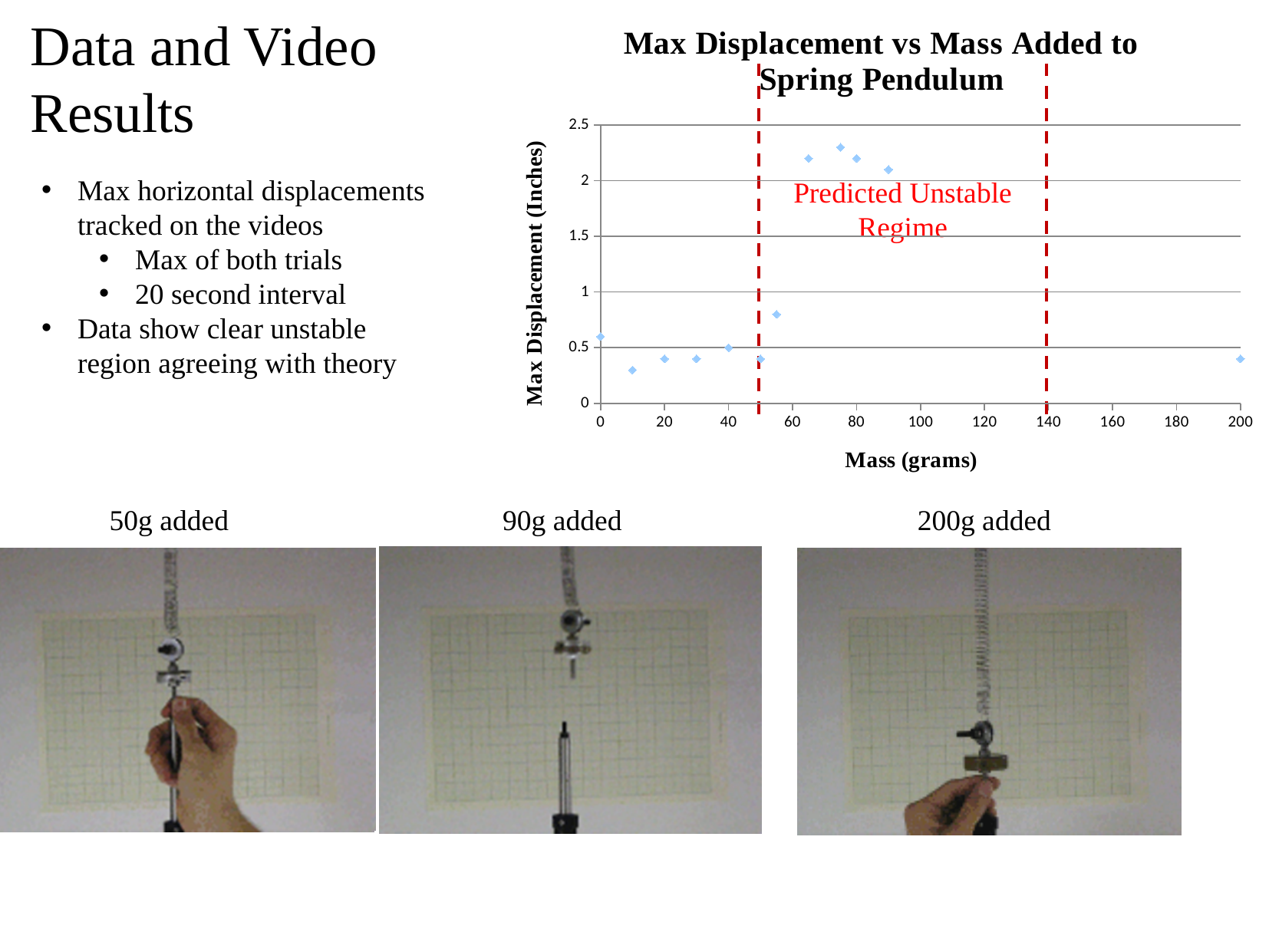
Is the max displacement at 75 grams greater or less than 2 inches? greater Is the max displacement at 200 grams greater or less than 1 inch? less What kind of chart is shown on the slide? scatter plot How many data points are plotted on the chart? 12 Which has the larger max displacement: 65 grams or 50 grams? 65 grams What is the title of the chart? Max Displacement vs Mass Added to Spring Pendulum Is the max displacement at 90 grams greater or less than 1.5 inches? greater Which has the larger max displacement: 75 grams or 200 grams? 75 grams Do the max displacement values rise or fall as mass increases from 50 grams to 75 grams? rise What is the label of the y axis of the chart? Max Displacement (Inches)